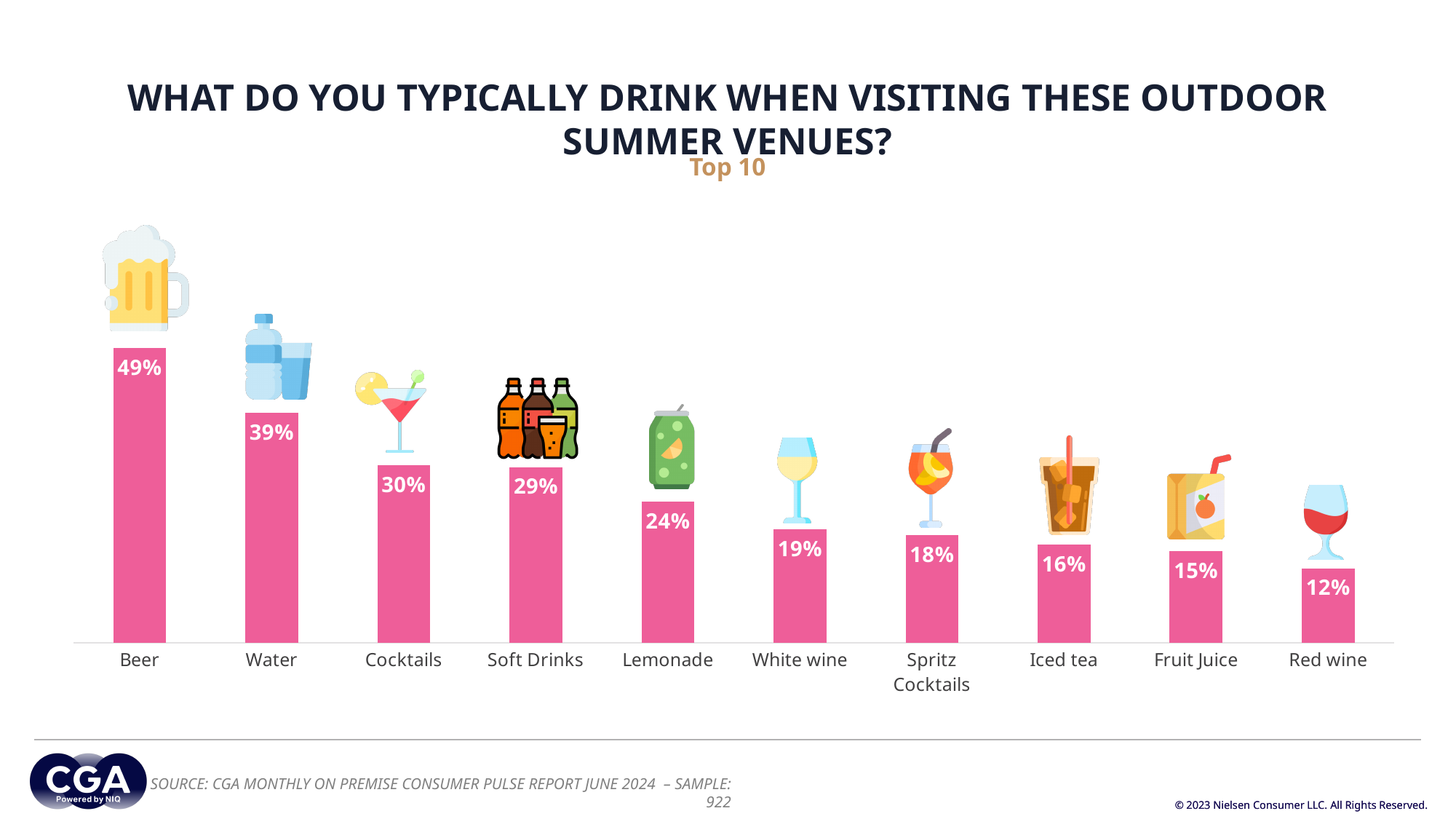
Which has a higher value, Iced tea or Fruit Juice? Iced tea Which drink has the highest percentage on the chart? Beer Do the values rise or fall moving from left to right along the x axis? Fall What type of chart is shown on the slide? Bar chart What is the difference in percentage points between White wine and Red wine? 7 Which has a higher value, Cocktails or Soft Drinks? Cocktails Which drink has the lowest percentage on the chart? Red wine What percentage of respondents typically drink beer when visiting outdoor summer venues? 49% What is the value shown for Lemonade? 24% What is the difference in percentage points between Beer and Water? 10 What is the value shown for Spritz Cocktails? 18% How many drink categories are shown on the chart? 10